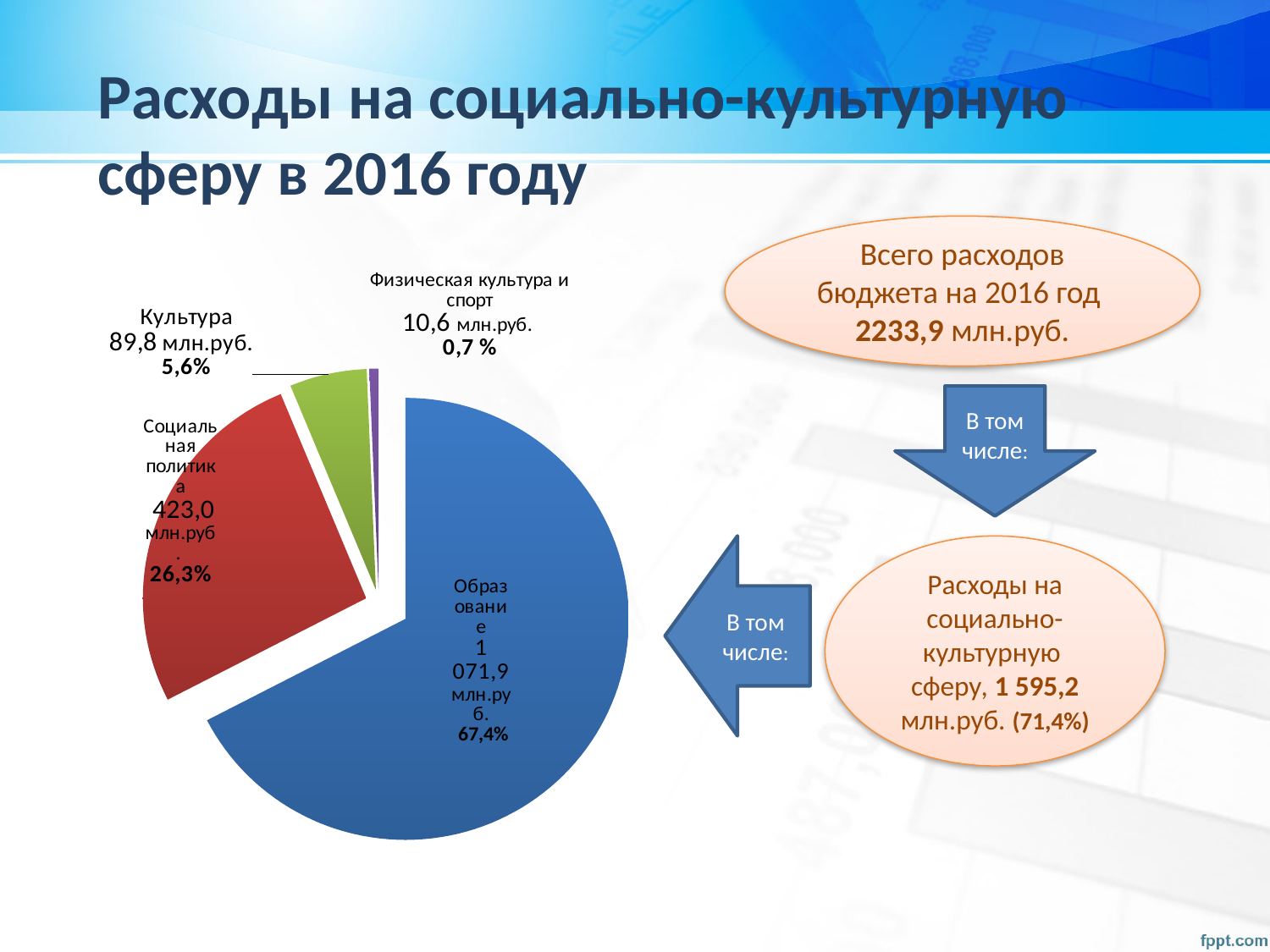
What is the value for Образование in the pie chart? 1 071,9 млн.руб. Which category has the smallest slice of the pie chart? Физическая культура и спорт Which is larger, the value for Культура or the value for Физическая культура и спорт? Культура What share of the pie does Социальная политика represent? 26,3% What is the value for Физическая культура и спорт in the pie chart? 10,6 млн.руб. What share of the pie does Образование represent? 67,4% What is the difference between the values for Социальная политика and Культура? 333,2 млн.руб. Which category has the largest slice of the pie chart? Образование How many slices does the pie chart have? 4 What kind of chart is shown on the slide? pie chart What is the value for Культура in the pie chart? 89,8 млн.руб. What is the value for Социальная политика in the pie chart? 423,0 млн.руб.